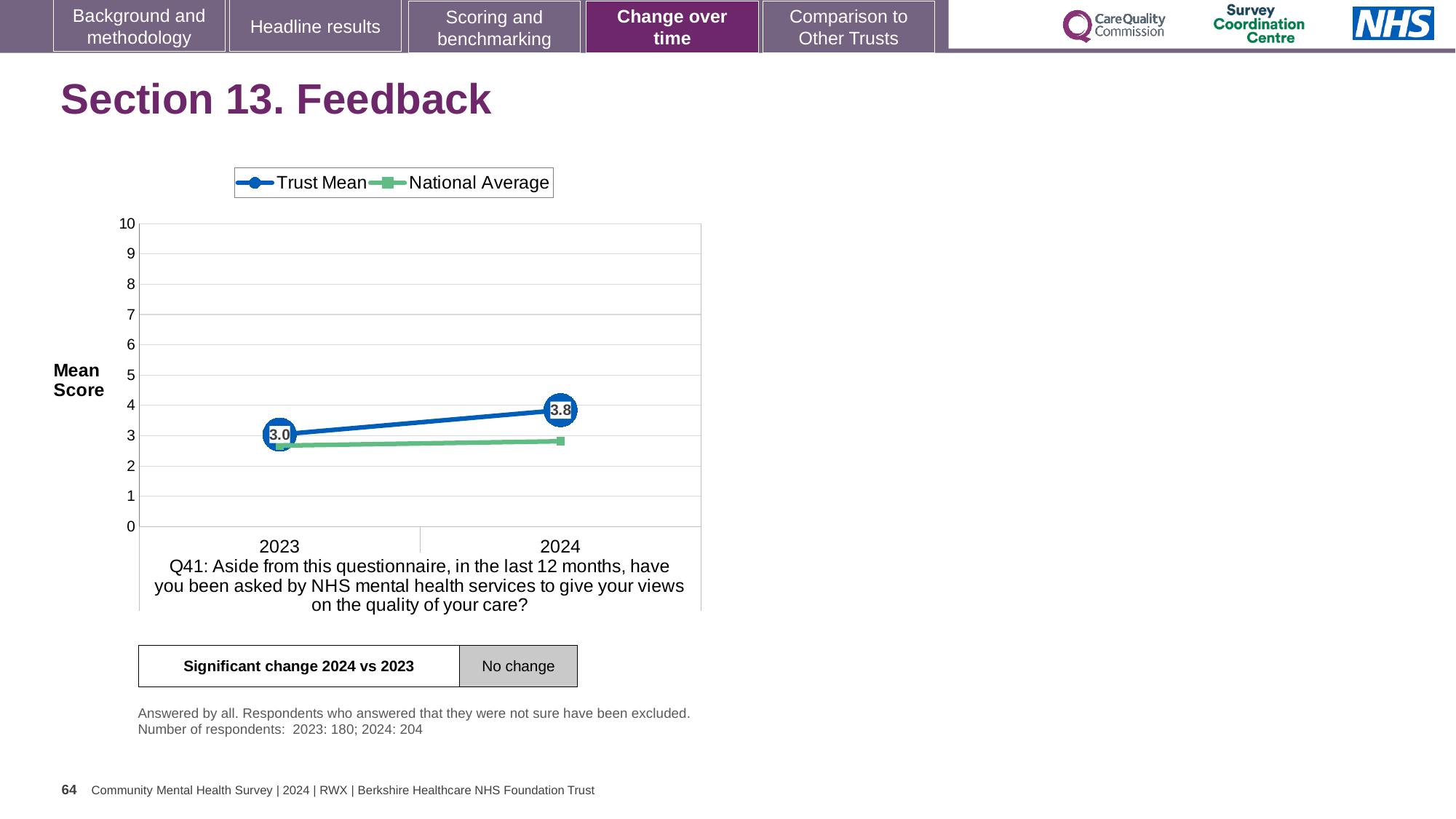
In which year is the Trust Mean score lowest? 2023 In 2024, which is larger: the Trust Mean or the National Average? Trust Mean What is the Trust Mean score for 2024? 3.8 Does the Trust Mean rise or fall from 2023 to 2024? rise How many years are plotted on the x axis? 2 By how much did the Trust Mean score change from 2023 to 2024? 0.8 What is the label on the y axis of the chart? Mean Score How many series does the legend list? 2 What is the Trust Mean score for 2023? 3.0 What kind of chart is shown on the slide? line chart Is the National Average value for 2024 greater or less than 4? less In which year is the Trust Mean score highest? 2024